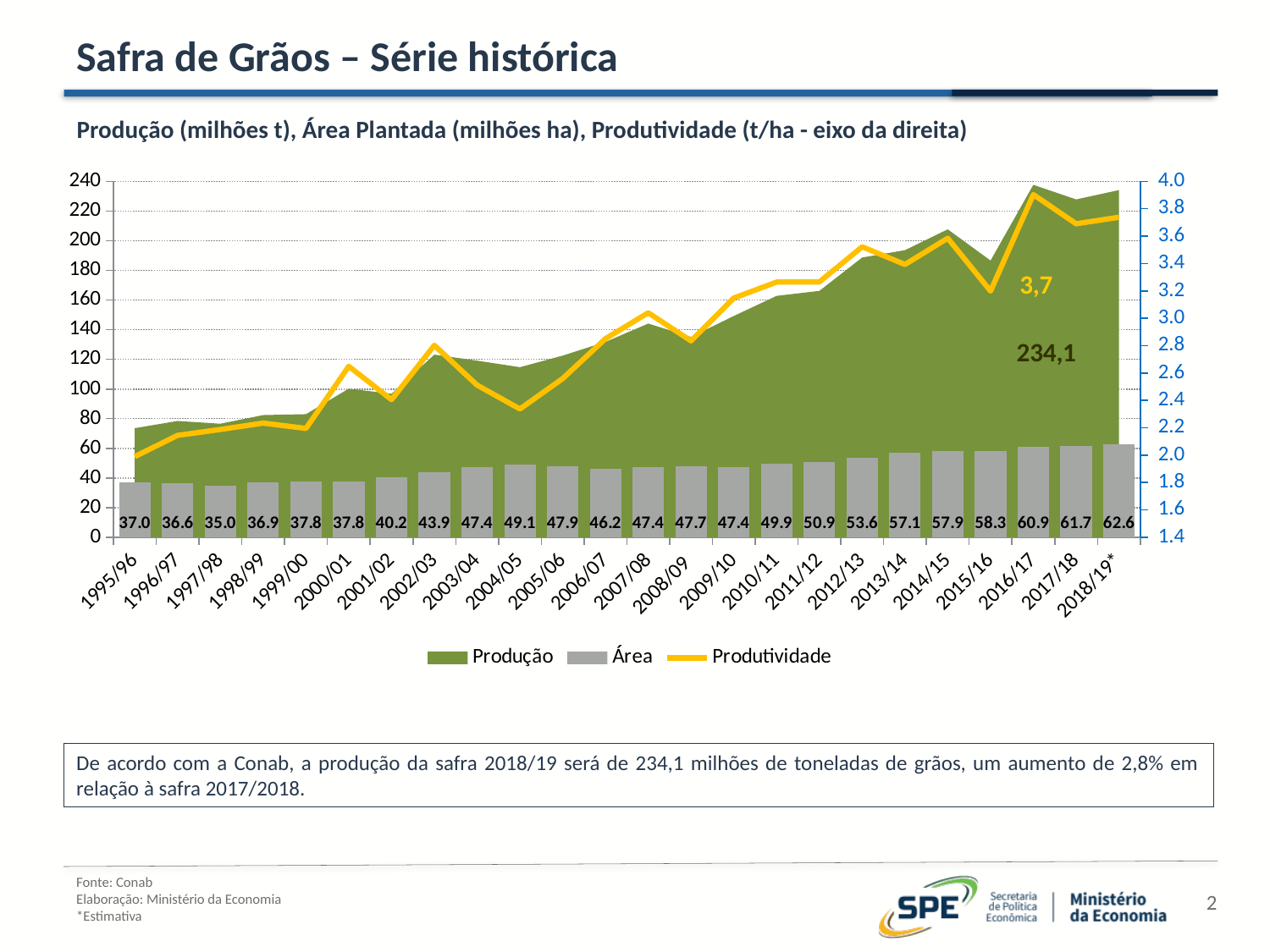
Which year has the lowest Área value? 1997/98 What is the value of Área for 1997/98? 35.0 How many series does the legend list? 3 What is the Produção value labelled for 2018/19*? 234,1 Which is larger, the Área value for 2004/05 or for 2005/06? 2004/05 What is the Produtividade value labelled for 2018/19*? 3,7 What is the difference between the Área values for 2018/19* and 2017/18? 0.9 Does the Área series generally rise or fall from 1995/96 to 2018/19*? rise Which year has the highest Área value? 2018/19* Is the Produção value for 2016/17 greater or less than 220? greater What is the value of Área for 2018/19*? 62.6 How many seasons are shown on the x axis? 24